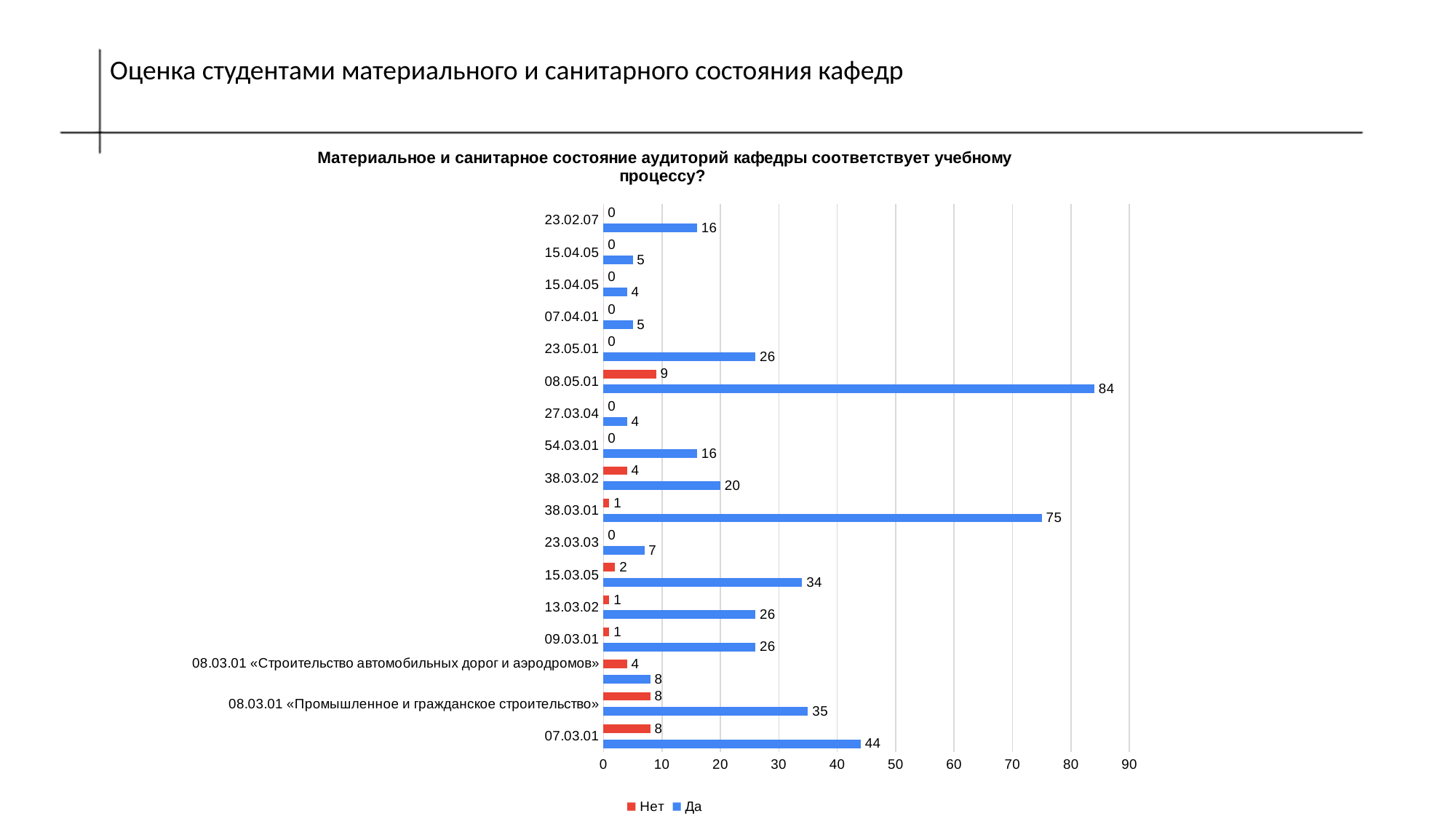
What is the difference between the "Да" values for 08.05.01 and 38.03.01? 9 How many series does the legend list? 2 What is the value of the "Нет" series for 38.03.02? 4 What is the total of the "Нет" and "Да" values for 38.03.02? 24 Which is larger: the "Да" value for 07.03.01 or for 08.03.01 «Промышленное и гражданское строительство»? 07.03.01 What is the value of the "Нет" series for 07.03.01? 8 Which category has the highest "Нет" value? 08.05.01 What kind of chart is shown on the slide? Bar chart What is the value of the "Да" series for 15.03.05? 34 Which colour represents the "Нет" series in the chart? Red Which category has the highest "Да" value? 08.05.01 What is the value of the "Да" series for 08.05.01? 84